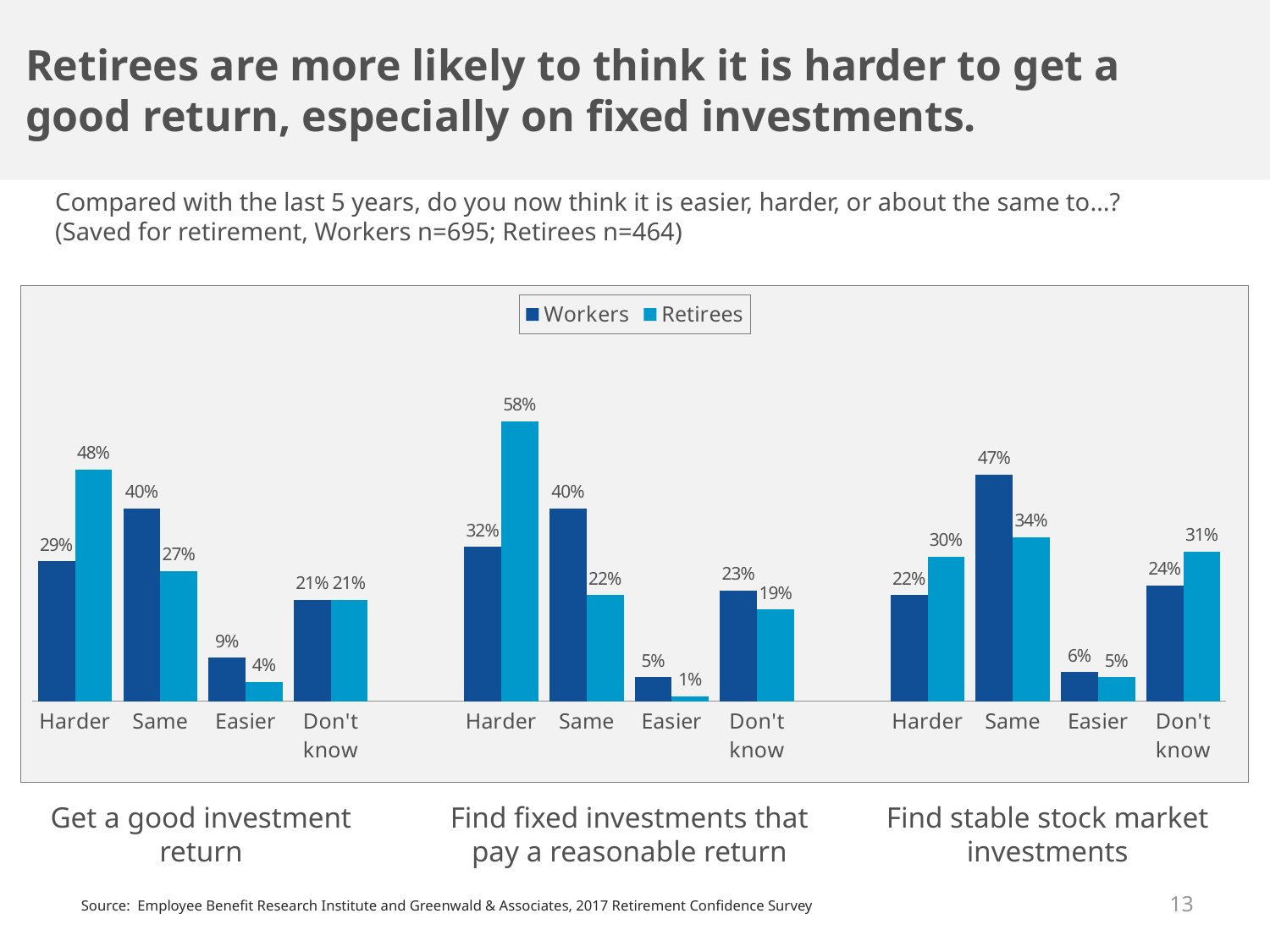
What percentage of Workers say it is about the same to find stable stock market investments? 47% For 'Get a good investment return', which group has the larger share answering 'Harder', Workers or Retirees? Retirees What is the difference between Retirees and Workers who say it is harder to find fixed investments that pay a reasonable return? 26% In the 'Get a good investment return' group, which response has the highest value for Workers? Same How many series does the legend list? 2 What percentage of Retirees say it is easier to get a good investment return? 4% What type of chart is shown on the slide? Bar chart What percentage of Retirees say it is harder to find fixed investments that pay a reasonable return? 58% For 'Find stable stock market investments', which group has the larger share answering 'Don't know', Workers or Retirees? Retirees How many response categories are shown in each group of the chart? 4 In the 'Find fixed investments that pay a reasonable return' group, which response has the lowest value for Retirees? Easier What is the difference between Workers and Retirees who say it is about the same to get a good investment return? 13%